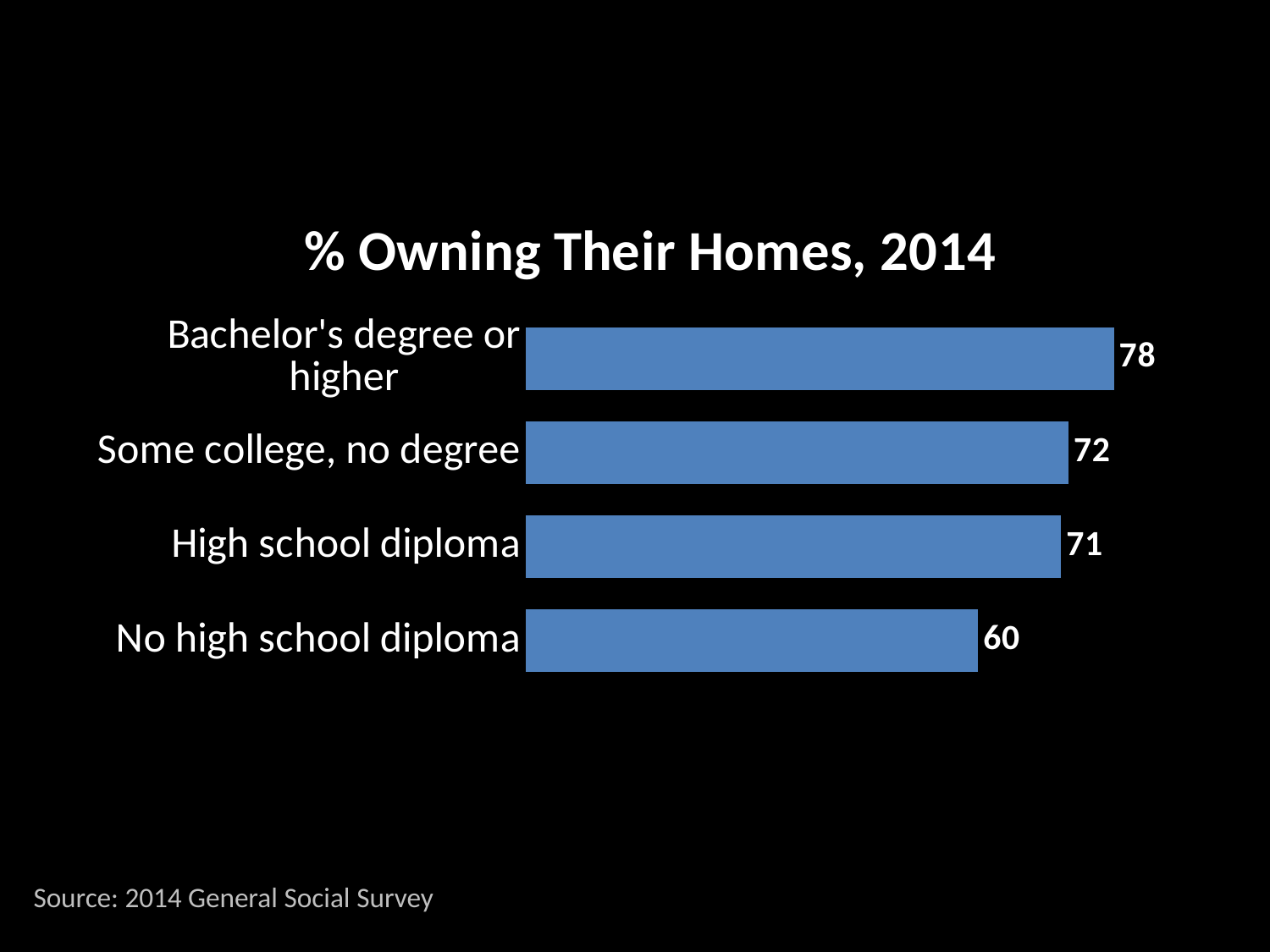
What is the difference between the values for Bachelor's degree or higher and No high school diploma? 18 What is the value for Bachelor's degree or higher? 78 Which is larger, the value for Some college, no degree or the value for No high school diploma? Some college, no degree What is the value for High school diploma? 71 What is the difference between the values for Some college, no degree and High school diploma? 1 What is the value for Some college, no degree? 72 Which category has the highest value? Bachelor's degree or higher What is the title of the chart? % Owning Their Homes, 2014 What kind of chart is shown on the slide? Bar chart How many categories are shown in the chart? 4 Which category has the lowest value? No high school diploma What is the value for No high school diploma? 60